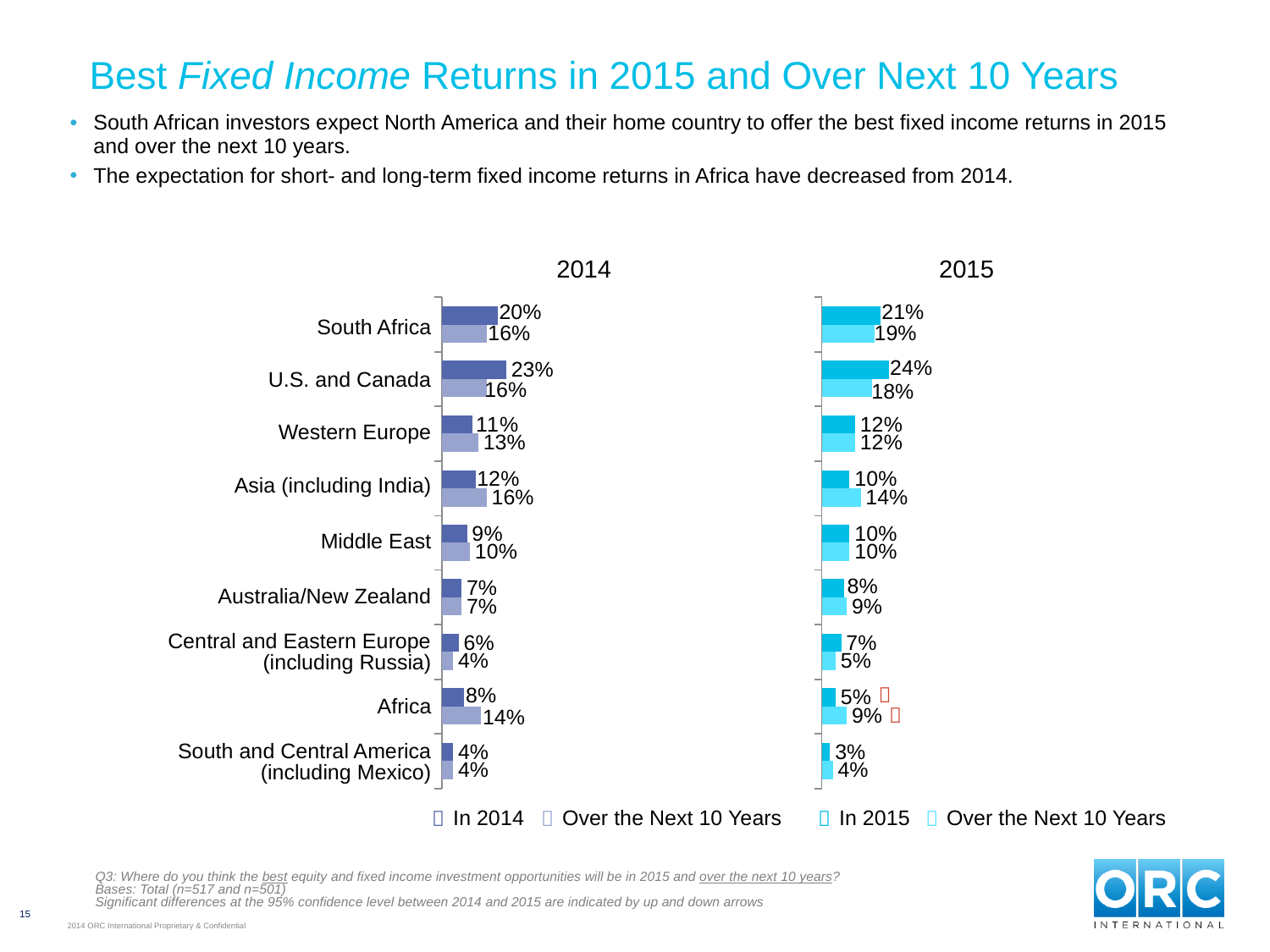
In the 2014 chart, what is the 'Over the Next 10 Years' value for Western Europe? 13% How many series does the legend of the 2015 chart list? 2 In the 2014 chart, what is the difference between the 'Over the Next 10 Years' value and the 'In 2014' value for Africa? 6% In the 2015 chart, what is the 'In 2015' value for Africa? 5% In the 2014 chart, what is the 'In 2014' value for U.S. and Canada? 23% What is the title of the chart on the right side of the slide? 2015 In the 2014 chart, which region has the highest 'In 2014' value? U.S. and Canada In the 2015 chart, which region has the lowest 'In 2015' value? South and Central America (including Mexico) What type of chart is the 2015 chart? Bar chart In the 2015 chart, which is larger for Asia (including India): the 'In 2015' value or the 'Over the Next 10 Years' value? Over the Next 10 Years In the 2015 chart, what is the 'Over the Next 10 Years' value for South Africa? 19% How many regions are shown in the 2014 chart? 9